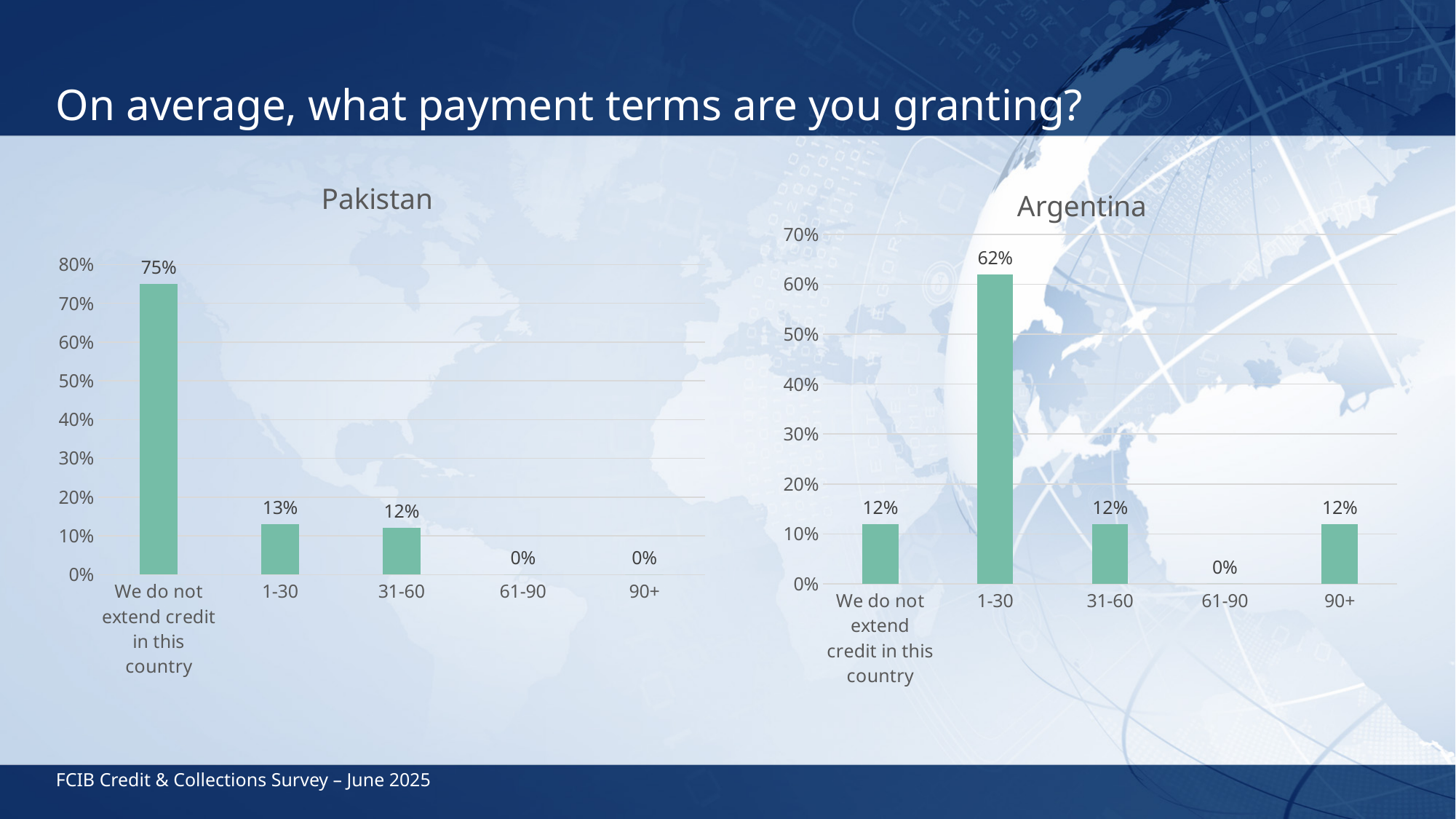
In the Argentina chart, what is the value for the 90+ category? 12% In the Pakistan chart, what percentage of respondents said they do not extend credit in this country? 75% In the Argentina chart, what is the difference between the 1-30 value and the 31-60 value? 50% How many categories are shown on the x axis of the Pakistan chart? 5 In the Pakistan chart, which category has the highest value? We do not extend credit in this country In the Argentina chart, what is the value for the 1-30 category? 62% In the Argentina chart, what is the value for the 61-90 category? 0% In the Argentina chart, which category has the highest value? 1-30 In the Pakistan chart, what is the value for the 31-60 category? 12% In the Pakistan chart, what is the difference between the 'We do not extend credit in this country' value and the 1-30 value? 62% What type of chart is the Argentina chart? Bar chart Which is larger: the 1-30 value in the Pakistan chart or the 1-30 value in the Argentina chart? Argentina